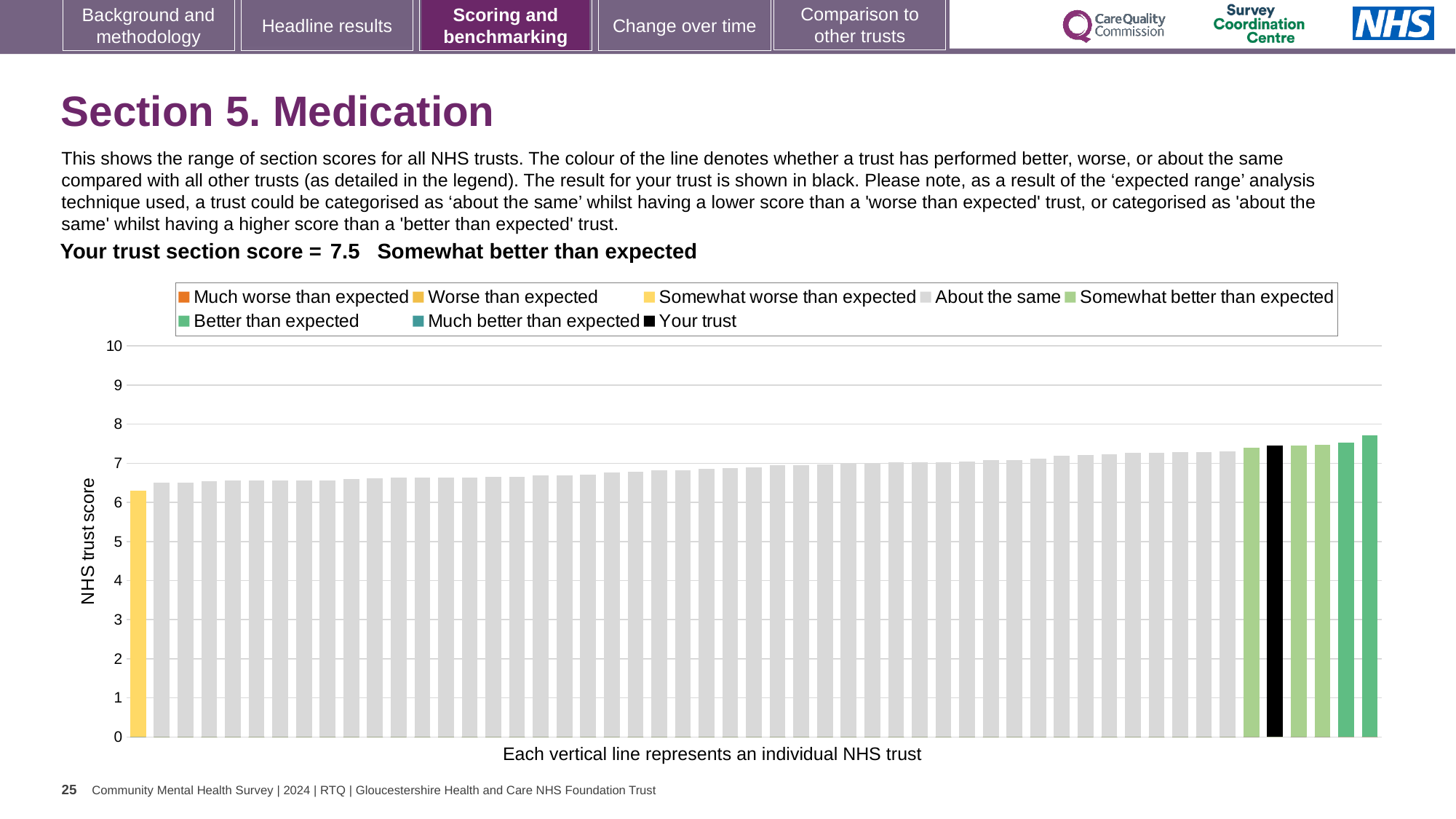
What is the label on the vertical axis of the chart? NHS trust score How many entries does the chart legend list? 8 What kind of chart is shown on the slide? bar chart What colour is the bar representing your trust? black Do the bar values rise or fall from left to right along the x axis? rise What is the section score for your trust shown on the slide? 7.5 Is the value for your trust greater or less than 7? greater Is the value for your trust greater or less than 8? less